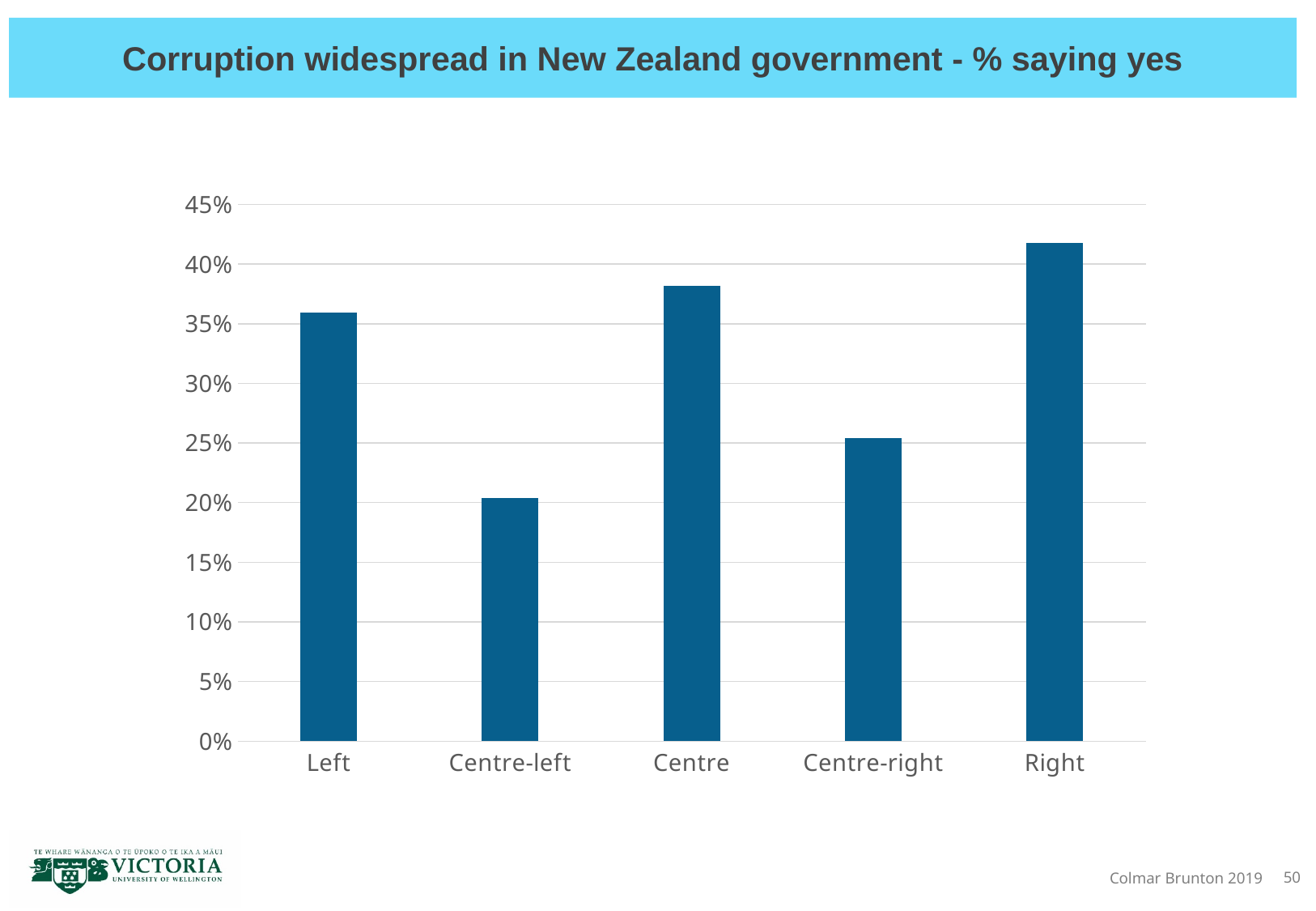
Is the value for Centre-right greater or less than 30%? less Which category has the lowest value? Centre-left Which is larger, the value for Left or the value for Centre-right? Left Is the value for Centre greater or less than 35%? greater Is the value for Centre-left greater or less than 25%? less Which category has the highest value? Right What is the title of the chart? Corruption widespread in New Zealand government - % saying yes How many categories are shown on the x axis? 5 What type of chart is shown on the slide? Bar chart Which is larger, the value for Centre or the value for Centre-left? Centre